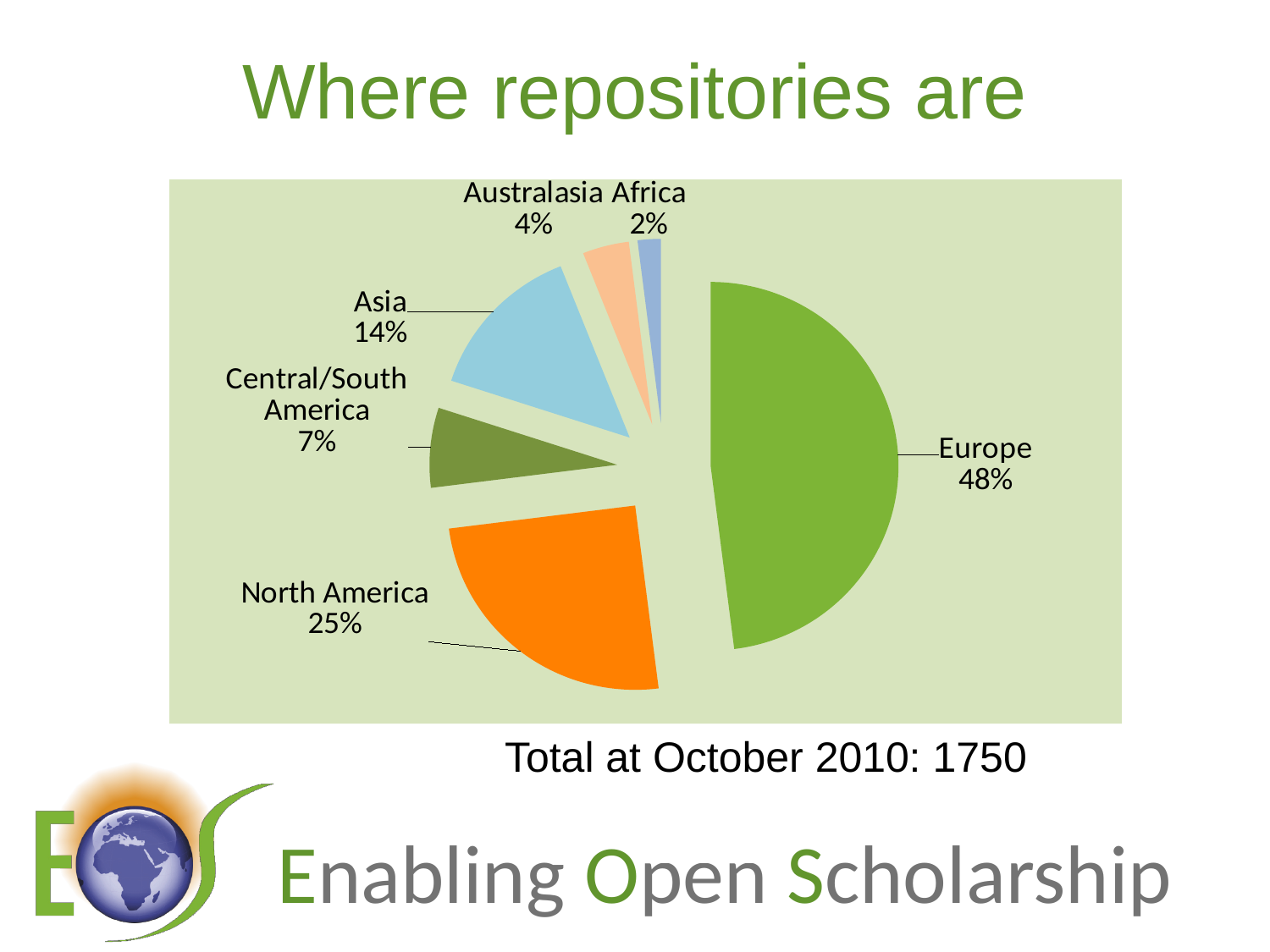
What share of repositories is in Australasia? 4% Which has a larger share of repositories, Asia or Central/South America? Asia What share of repositories is in Europe? 48% Which region has the smallest share of repositories? Africa How many regions are shown in the pie chart? 6 What share of repositories is in Central/South America? 7% What kind of chart is shown on the slide? Pie chart What share of repositories is in North America? 25% What is the difference in percentage points between Europe's share and North America's share? 23 Which region has the largest share of repositories? Europe What is the total number of repositories stated on the slide for October 2010? 1750 What share of repositories is in Asia? 14%